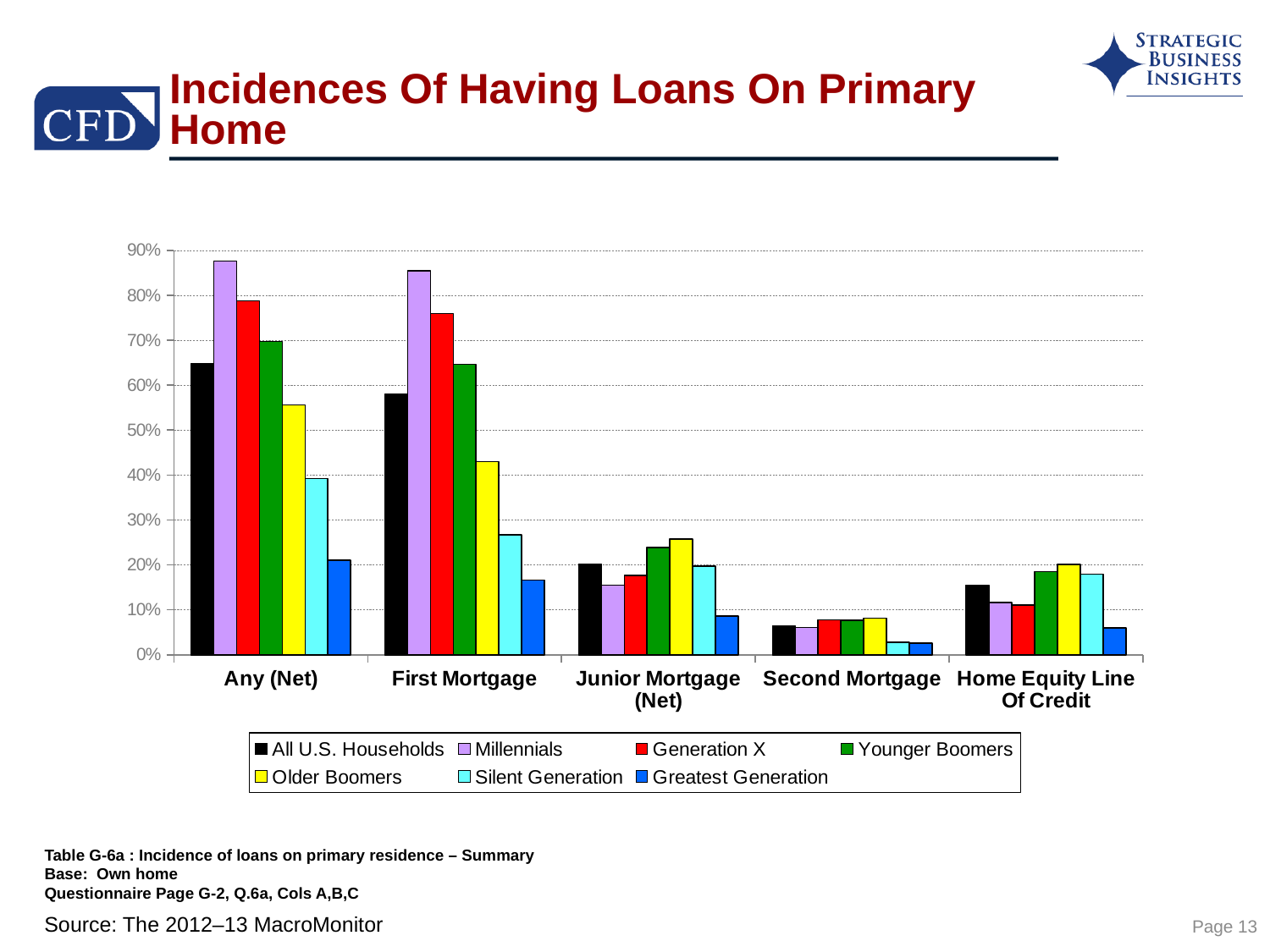
What kind of chart is shown on the slide? Bar chart How many series does the legend list? 7 How many loan categories are shown along the x axis? 5 Within the Any (Net) category, do the values rise or fall going from Millennials to Greatest Generation? fall Is the value for Millennials in First Mortgage greater or less than 80%? greater In Junior Mortgage (Net), which generation has the lowest incidence? Greatest Generation In the Any (Net) category, which generation has the lowest incidence? Greatest Generation In the Any (Net) category, which generation has the highest incidence? Millennials Is the value for Silent Generation in Any (Net) greater or less than 50%? less What colour represents Generation X in the legend? Red In First Mortgage, which is larger: Generation X or Younger Boomers? Generation X Is the value for All U.S. Households in Any (Net) greater or less than 60%? greater